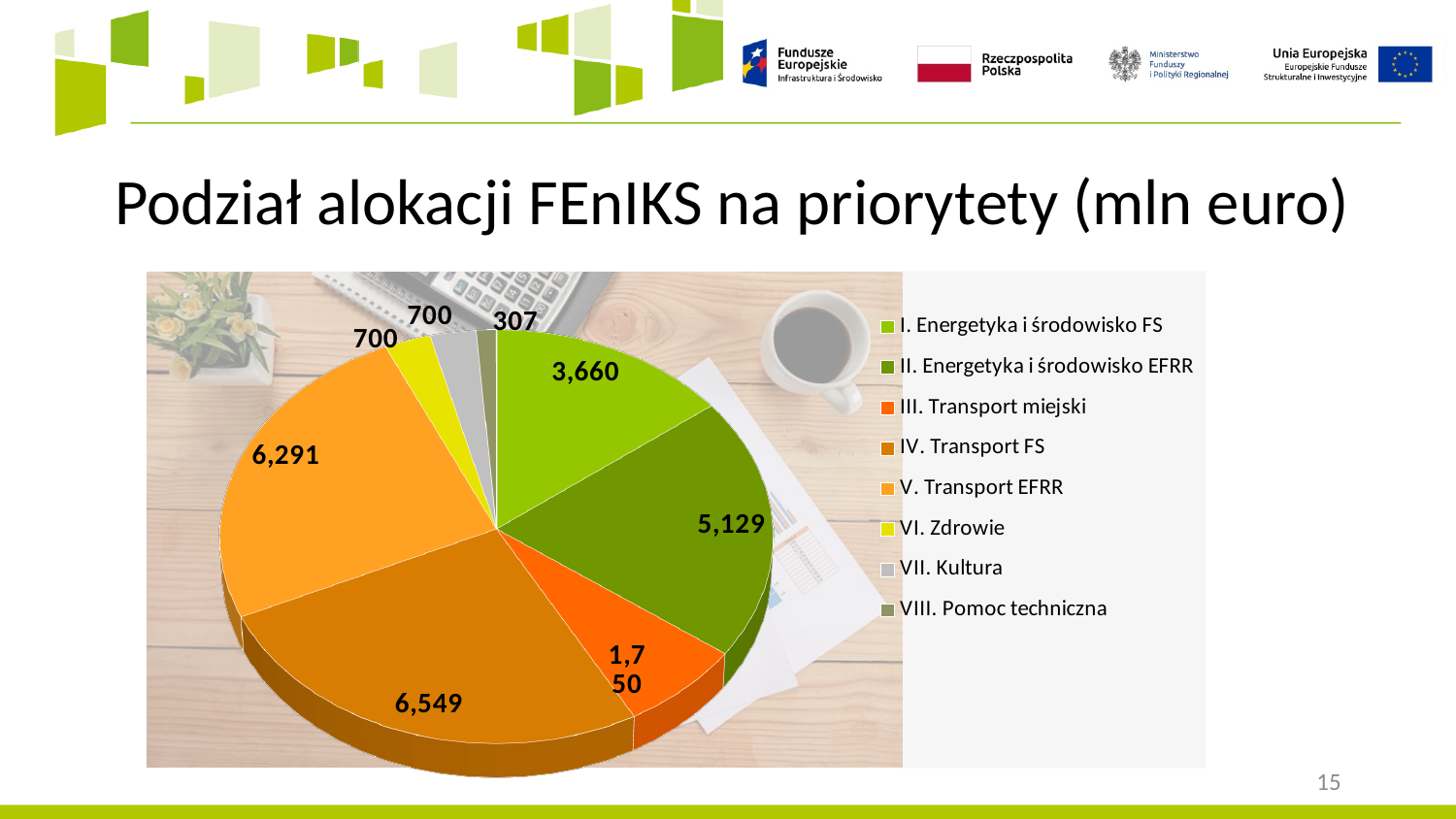
What kind of chart is shown on the slide? pie chart How many slices does the pie chart have? 8 Which is larger, the value for II. Energetyka i środowisko EFRR or the value for I. Energetyka i środowisko FS? II. Energetyka i środowisko EFRR How many entries does the legend list? 8 What is the value for I. Energetyka i środowisko FS? 3,660 What is the title of the chart? Podział alokacji FEnIKS na priorytety (mln euro) Which priority has the smallest allocation? VIII. Pomoc techniczna What is the value for II. Energetyka i środowisko EFRR? 5,129 What is the value for VIII. Pomoc techniczna? 307 What is the value for IV. Transport FS? 6,549 Which priority has the largest allocation? IV. Transport FS What is the difference between the values for IV. Transport FS and V. Transport EFRR? 258